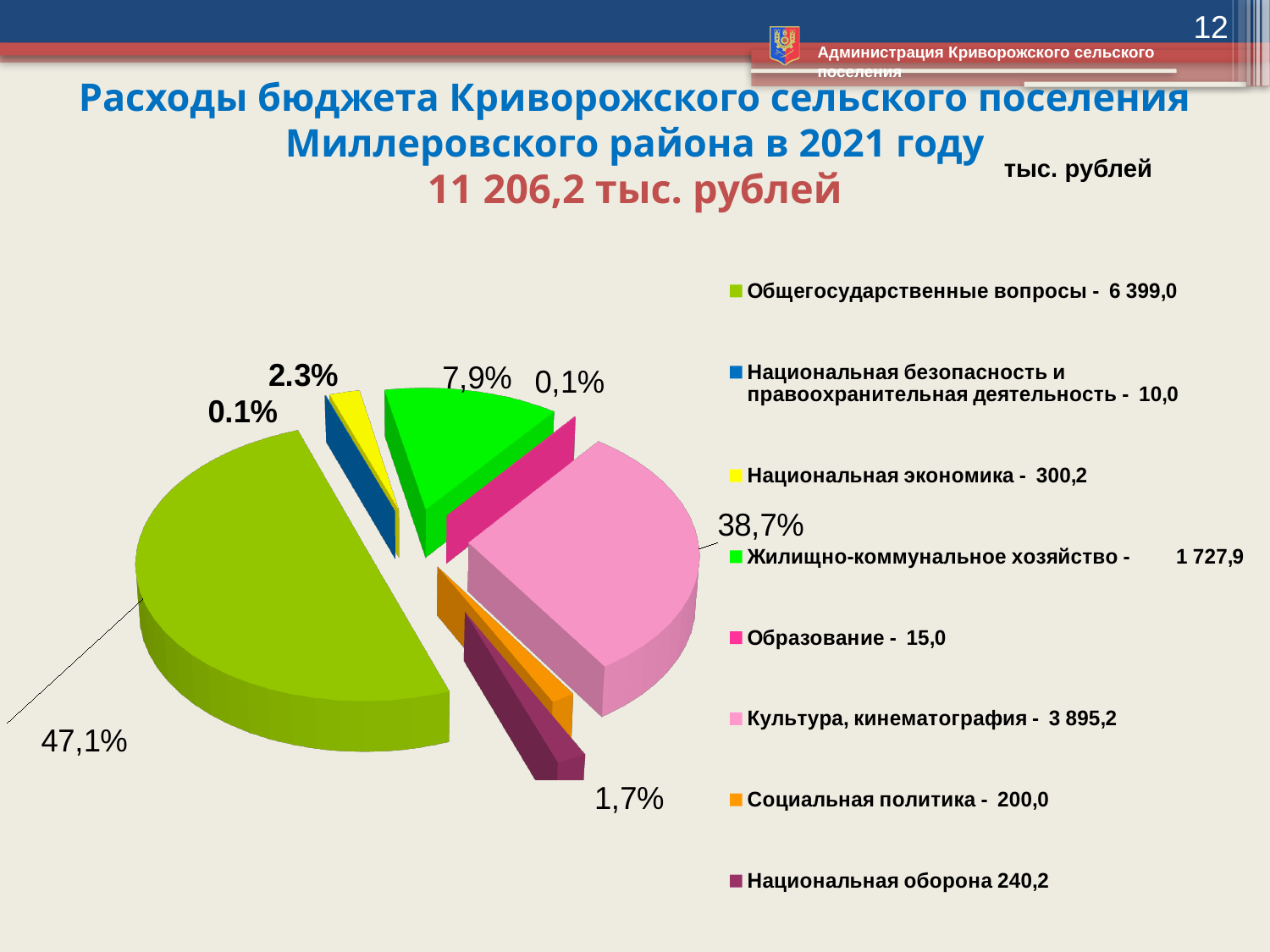
What share of the pie does Общегосударственные вопросы take, according to the data label? 47,1% Which expenditure category has the smallest value? Национальная безопасность и правоохранительная деятельность Which is larger: Социальная политика or Национальная оборона? Национальная оборона Which expenditure category has the largest value? Общегосударственные вопросы What kind of chart is shown on the slide? pie chart What is the value shown in the legend for Национальная оборона? 240,2 What is the value shown in the legend for Культура, кинематография? 3 895,2 What is the value shown in the legend for Образование? 15,0 What total budget expenditure amount is stated in the chart title? 11 206,2 тыс. рублей How many expenditure categories does the legend of the pie chart list? 8 What is the difference between the values for Общегосударственные вопросы and Культура, кинематография? 2 503,8 What is the value shown in the legend for Общегосударственные вопросы? 6 399,0